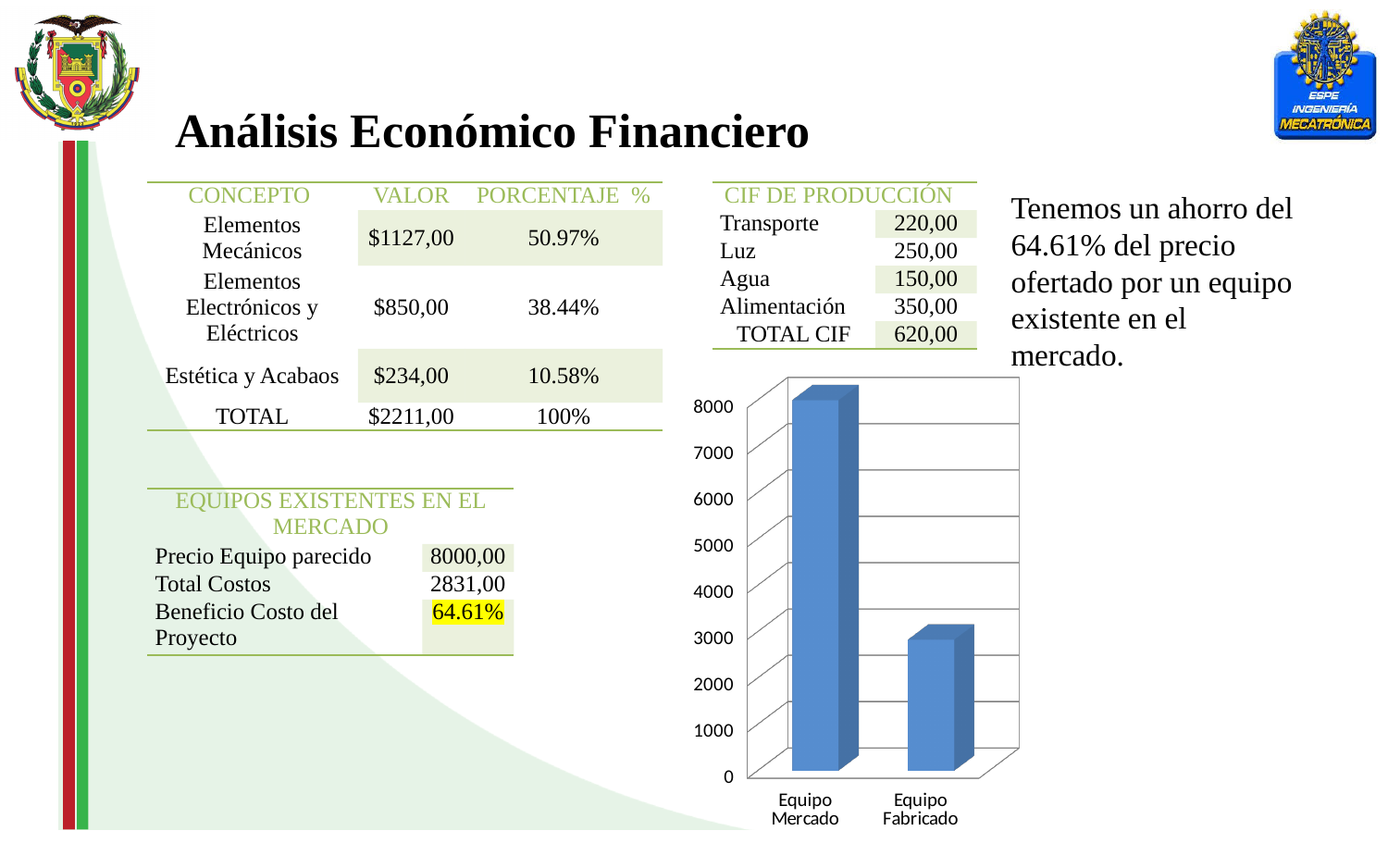
Which is larger in the bar chart, Equipo Mercado or Equipo Fabricado? Equipo Mercado Is the value for Equipo Fabricado greater or less than 2000? greater Which category has the lowest value in the bar chart? Equipo Fabricado What colour are the bars in the chart? blue Is the value for Equipo Mercado greater or less than 7000? greater How many categories are plotted on the bar chart? 2 What is the highest tick value shown on the vertical axis of the bar chart? 8000 Which category has the highest value in the bar chart? Equipo Mercado Do the values rise or fall from Equipo Mercado to Equipo Fabricado along the x axis? fall What kind of chart is shown on the slide? bar chart